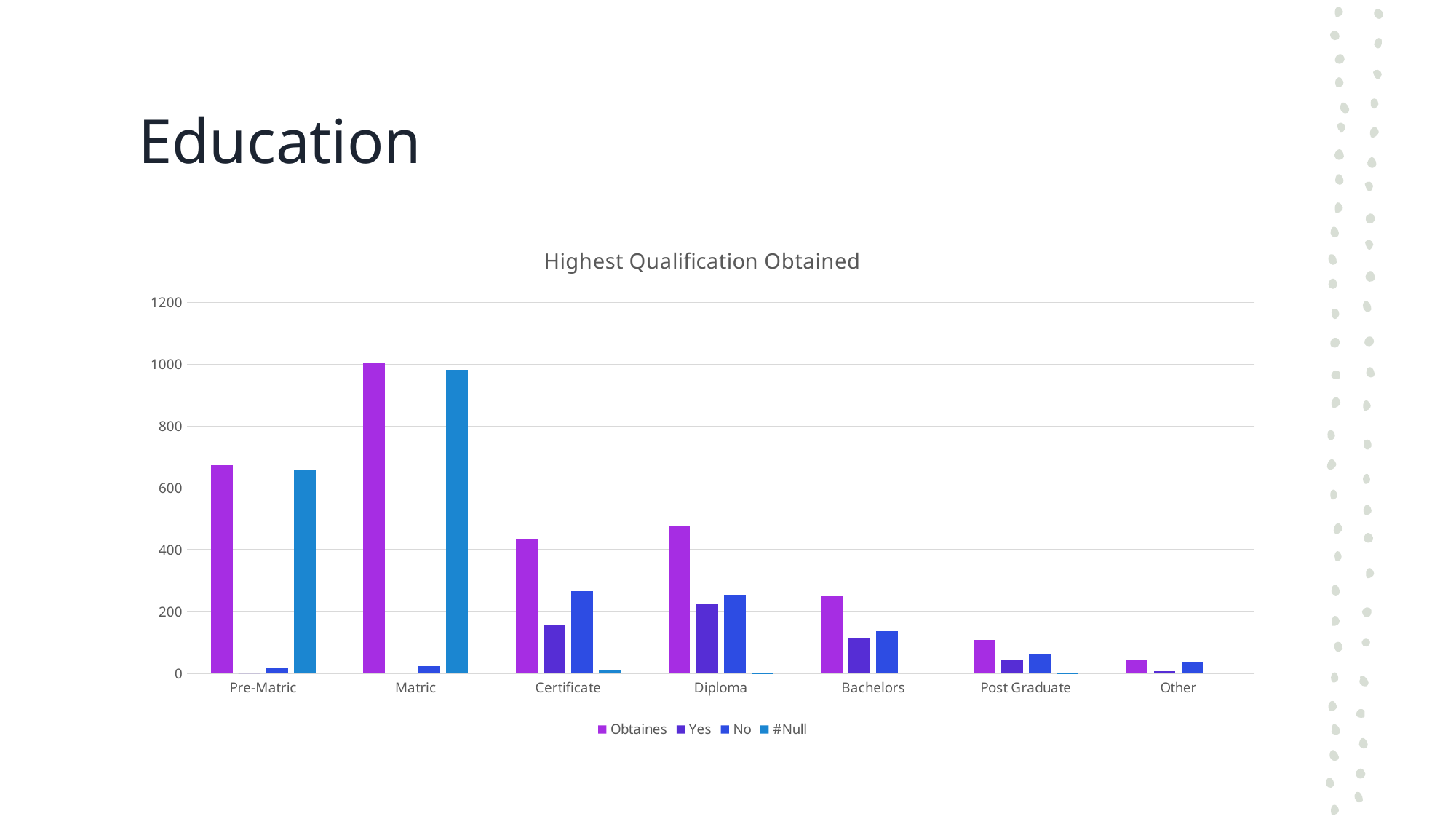
Is the Obtaines value for Certificate greater or less than 400? greater Is the #Null value for Matric greater or less than 800? greater Which category has the highest Obtaines value? Matric What kind of chart is shown on the slide? bar chart Is the Obtaines value for Pre-Matric greater or less than 600? greater For Certificate, which is larger: the Yes value or the No value? No Which category has the lowest Obtaines value? Other What is the title of the chart? Highest Qualification Obtained How many series does the legend list? 4 How many qualification categories are shown on the x axis? 7